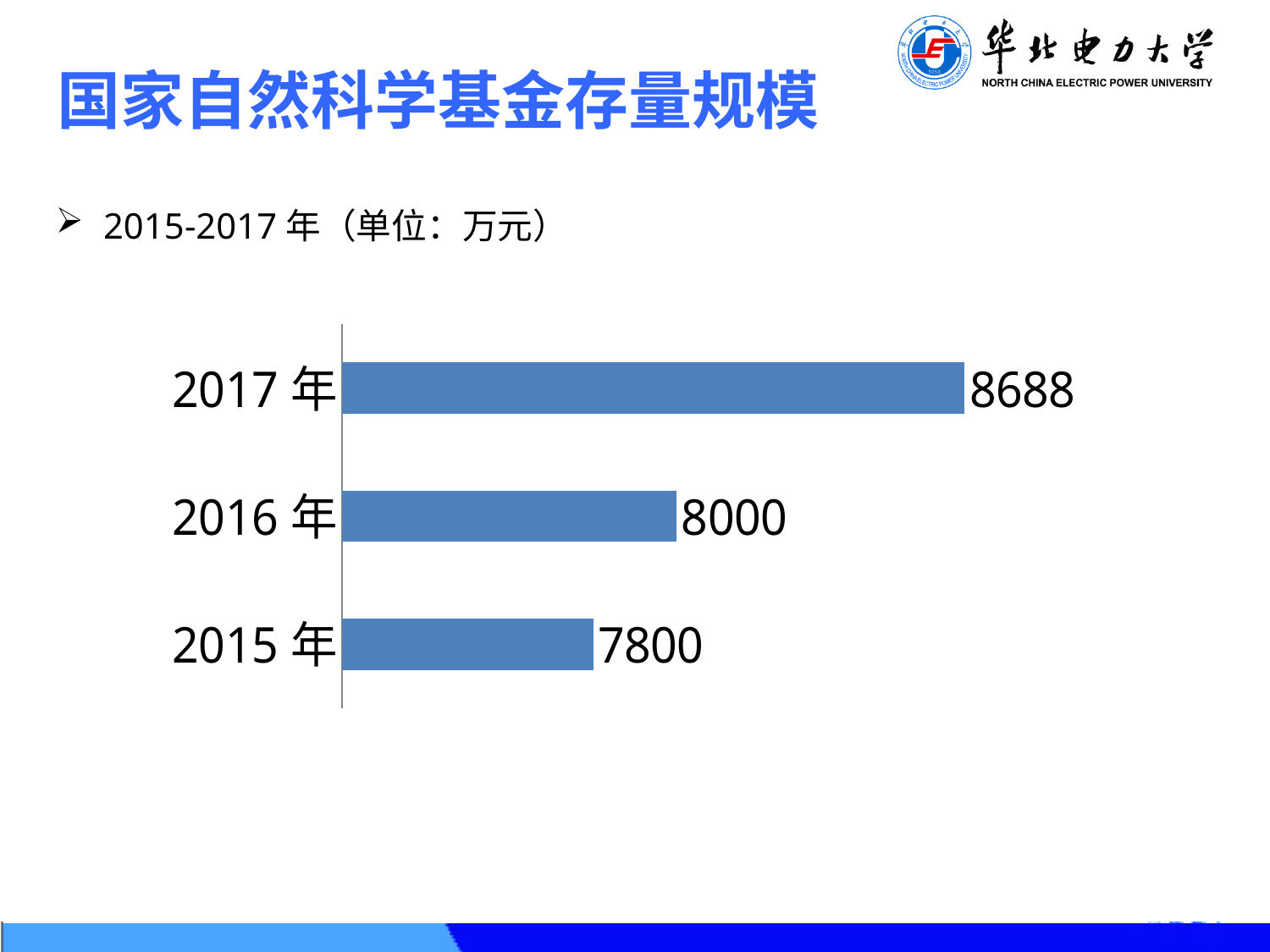
What is the difference between the values for 2017 年 and 2016 年? 688 What is the value for 2016 年? 8000 What is the value for 2017 年? 8688 What is the difference between the values for 2016 年 and 2015 年? 200 Which is larger, the value for 2016 年 or the value for 2015 年? 2016 年 How many years are shown in the chart? 3 What unit is stated for the values in the chart? 万元 Which year has the highest value? 2017 年 What kind of chart is shown on the slide? bar chart Which year has the lowest value? 2015 年 Do the values rise or fall from 2015 年 to 2017 年? rise What is the value for 2015 年? 7800